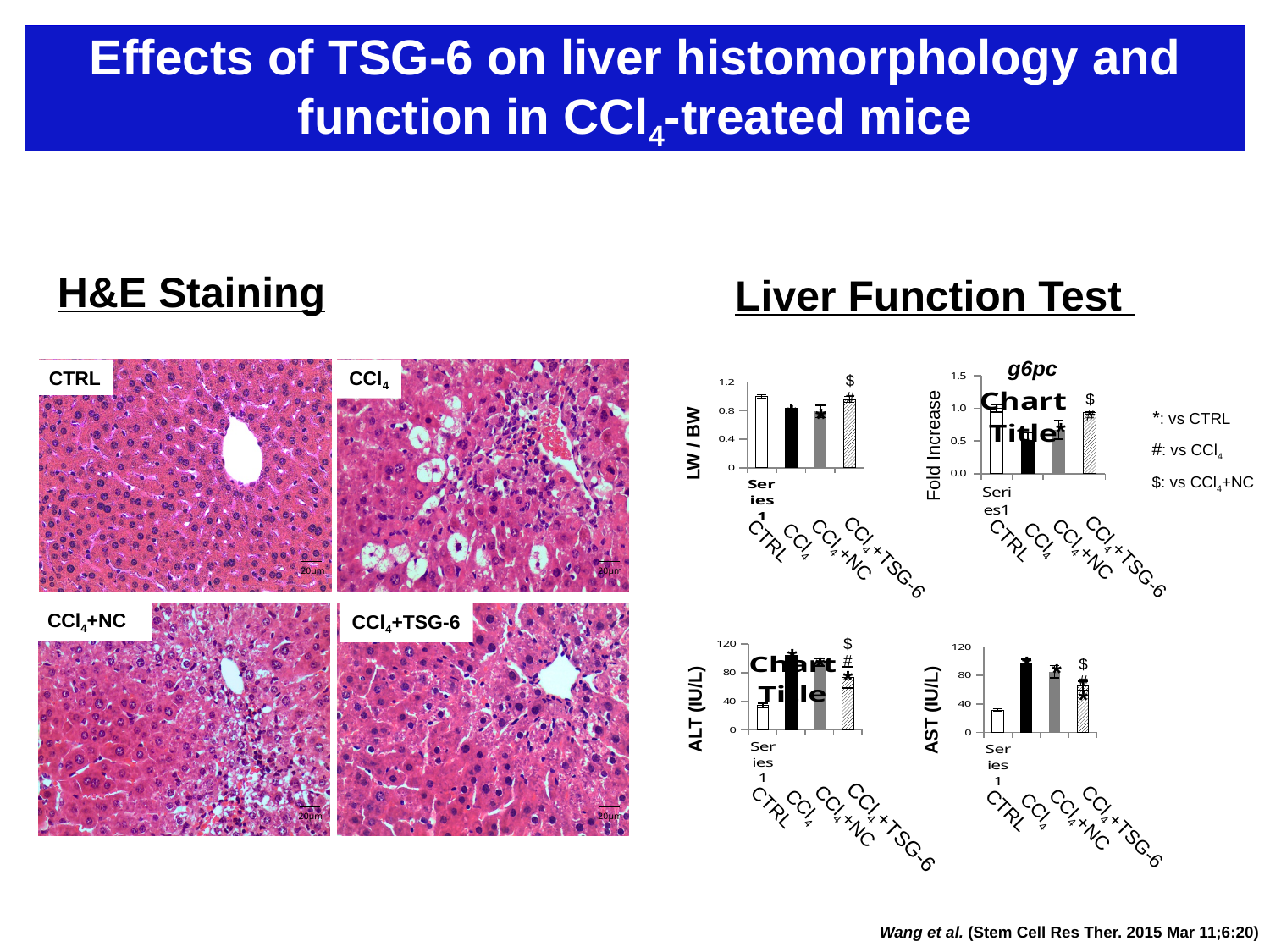
In the LW / BW chart, is the value for CTRL greater or less than 0.8? greater In the ALT (IU/L) chart, is the value for CCl4 greater or less than 80? greater What kind of chart is the ALT (IU/L) chart? bar chart In the AST (IU/L) chart, which category has the highest value? CCl4 How many categories are shown on the x axis of the AST (IU/L) chart? 4 In the ALT (IU/L) chart, is the value for CTRL greater or less than 40? less In the AST (IU/L) chart, which category has the lowest value? CTRL In the ALT (IU/L) chart, which category has the lowest value? CTRL In the ALT (IU/L) chart, which category has the highest value? CCl4 In the AST (IU/L) chart, which is larger, the value for CTRL or the value for CCl4+TSG-6? CCl4+TSG-6